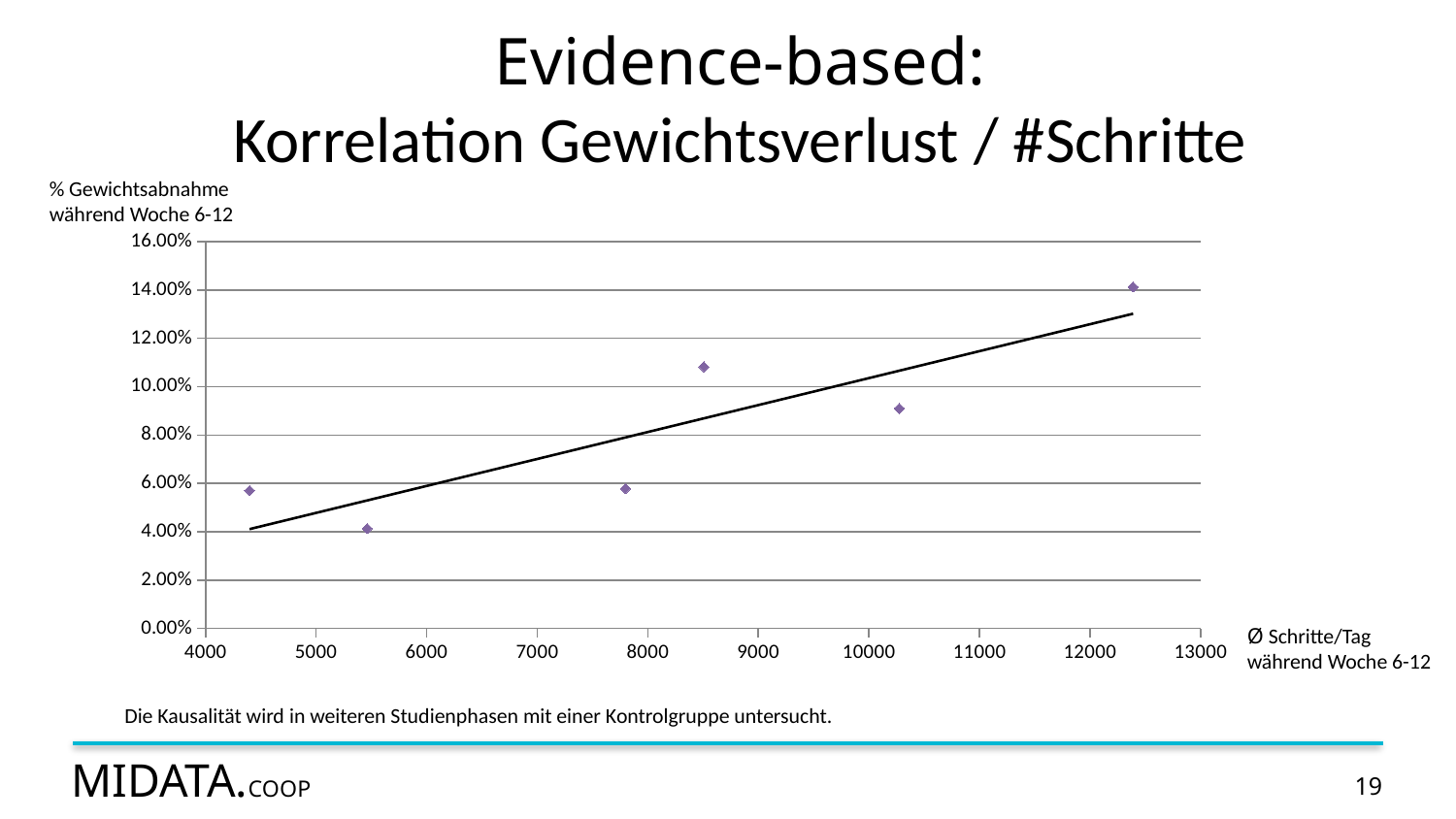
What kind of chart is shown on the slide? scatter chart Is the % Gewichtsabnahme for the point at about 12400 Schritte/Tag greater or less than 12.00%? greater Does the trend line show weight loss rising or falling as the number of steps per day increases? rising What is the label of the vertical axis? % Gewichtsabnahme während Woche 6-12 Is the % Gewichtsabnahme for the point at about 10250 Schritte/Tag greater or less than 10.00%? less Does the point with the highest % Gewichtsabnahme also have the highest number of Schritte/Tag? yes Which has the higher % Gewichtsabnahme: the point at about 8500 Schritte/Tag or the point at about 10250 Schritte/Tag? the point at about 8500 Schritte/Tag Is the % Gewichtsabnahme for the point at about 5500 Schritte/Tag greater or less than 6.00%? less How many data points are plotted in the chart? 6 What is the label of the horizontal axis? Ø Schritte/Tag während Woche 6-12